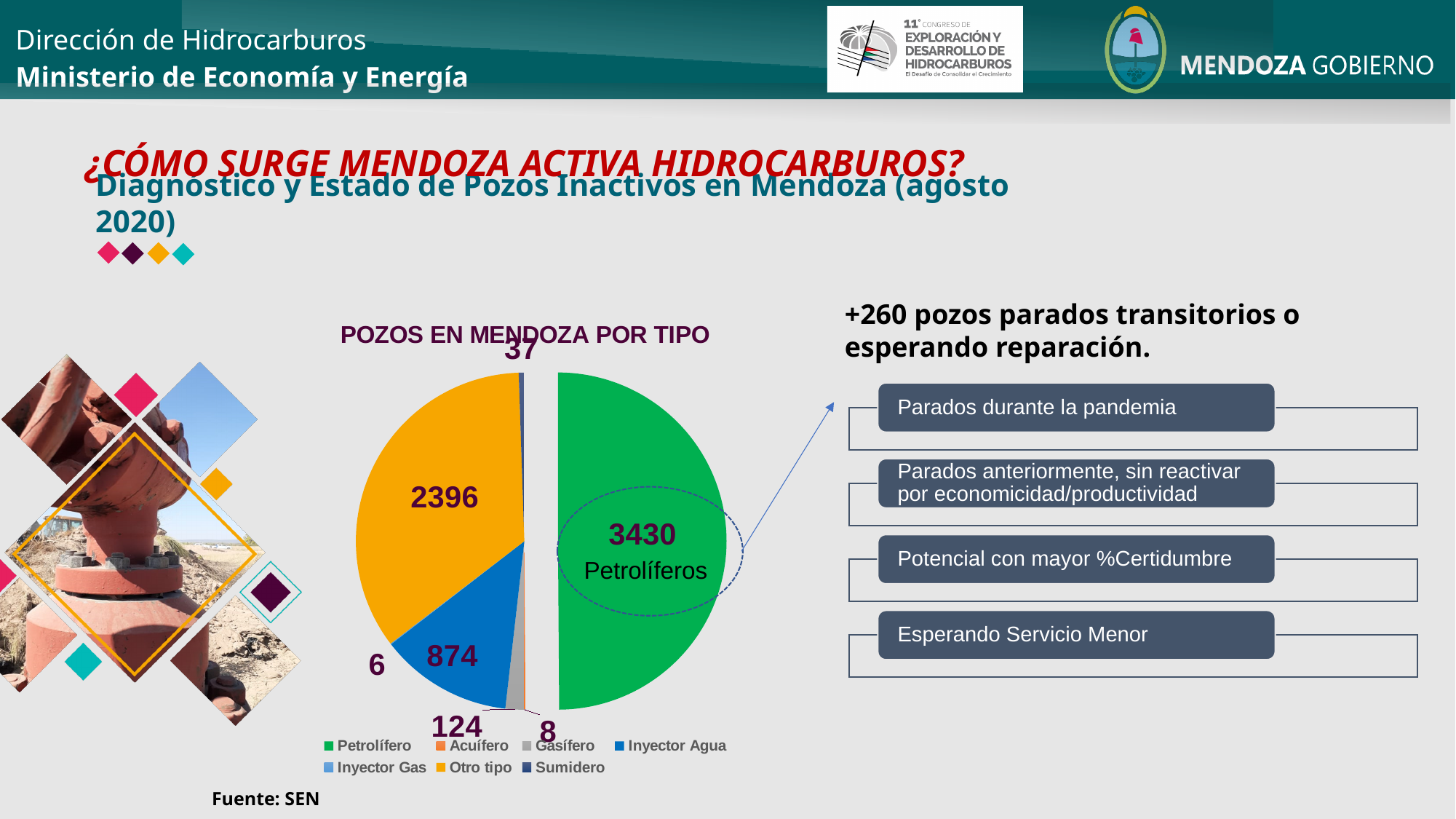
What is the value shown for Inyector Agua? 874 What is the value shown for Otro tipo? 2396 How many categories does the chart's legend list? 7 Which slice is pulled out (separated) from the rest of the pie? Petrolífero Which is larger, Otro tipo or Inyector Agua? Otro tipo What is the value shown for Sumidero? 37 What is the difference between the Petrolífero value and the Otro tipo value? 1034 What is the value shown for Petrolífero? 3430 What kind of chart is shown on the slide? Pie chart Which category has the largest slice of the pie? Petrolífero What is the total of all the values shown in the pie chart? 6875 What is the title of the chart? POZOS EN MENDOZA POR TIPO